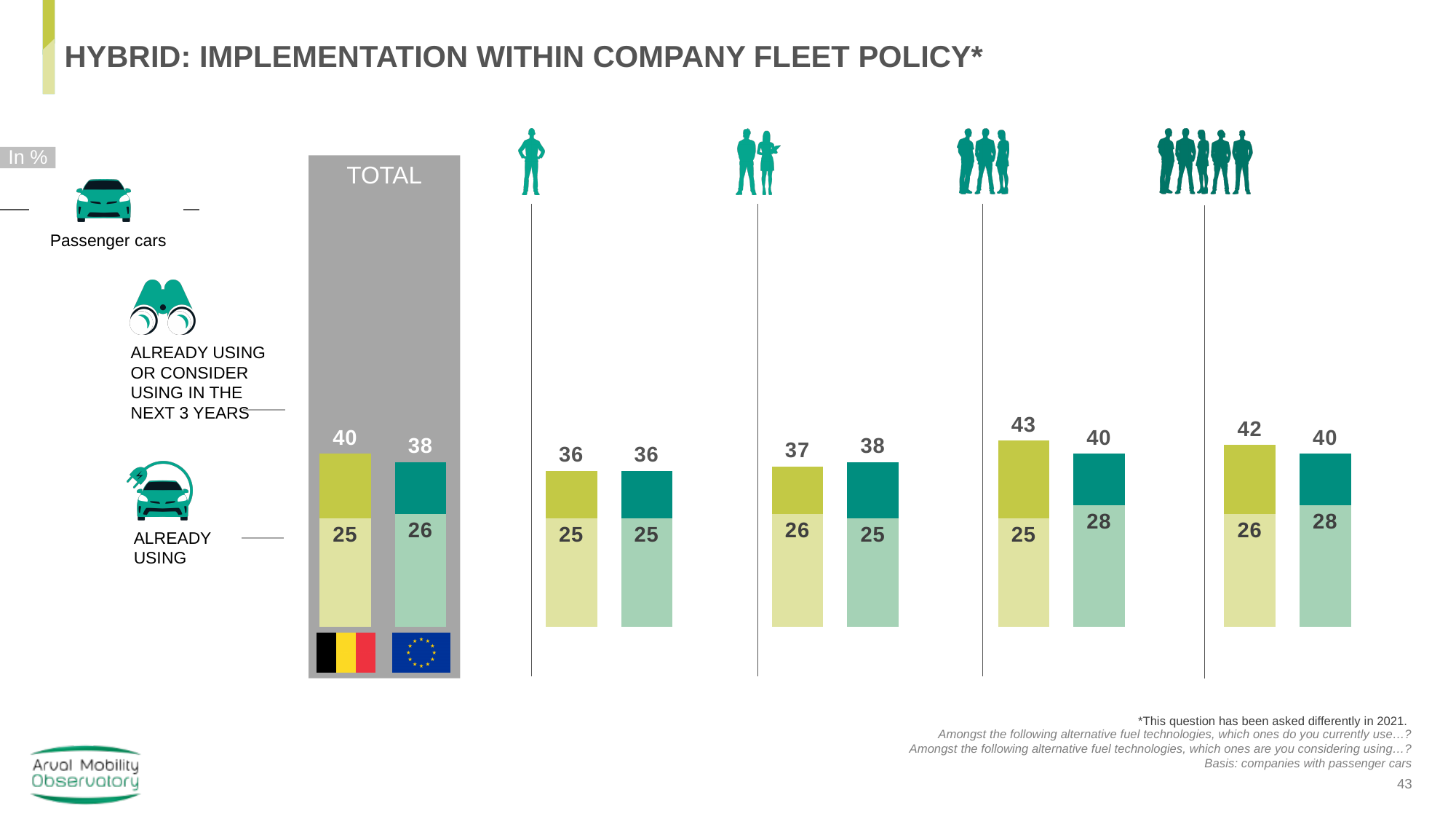
In the TOTAL column, what is the 'already using' value for Belgium? 25 Among the Belgian bars, which company-size group has the lowest 'already using or consider using' value? The group with the single-person icon (36) Among the Belgian bars, which company-size group has the highest 'already using or consider using' value? The group with the three-person icon (43) In the rightmost group (five-person icon), what is the 'already using' value for Europe? 28 In the TOTAL column, what is the difference between the Belgian and European 'already using or consider using' values? 2 In the group with the three-person icon, which is larger for 'already using or consider using': Belgium or Europe? Belgium In the TOTAL column, what percentage of Belgian companies are already using or consider using hybrid in the next 3 years? 40 In the rightmost group (five-person icon), what is the difference between the Belgian and European 'already using or consider using' values? 2 Which two flags are shown under the TOTAL bars? Belgium and the European Union In the TOTAL column, what percentage of European companies are already using hybrid? 26 What kind of chart is shown on the slide? Bar chart How many groups of bars are shown, including TOTAL? 5